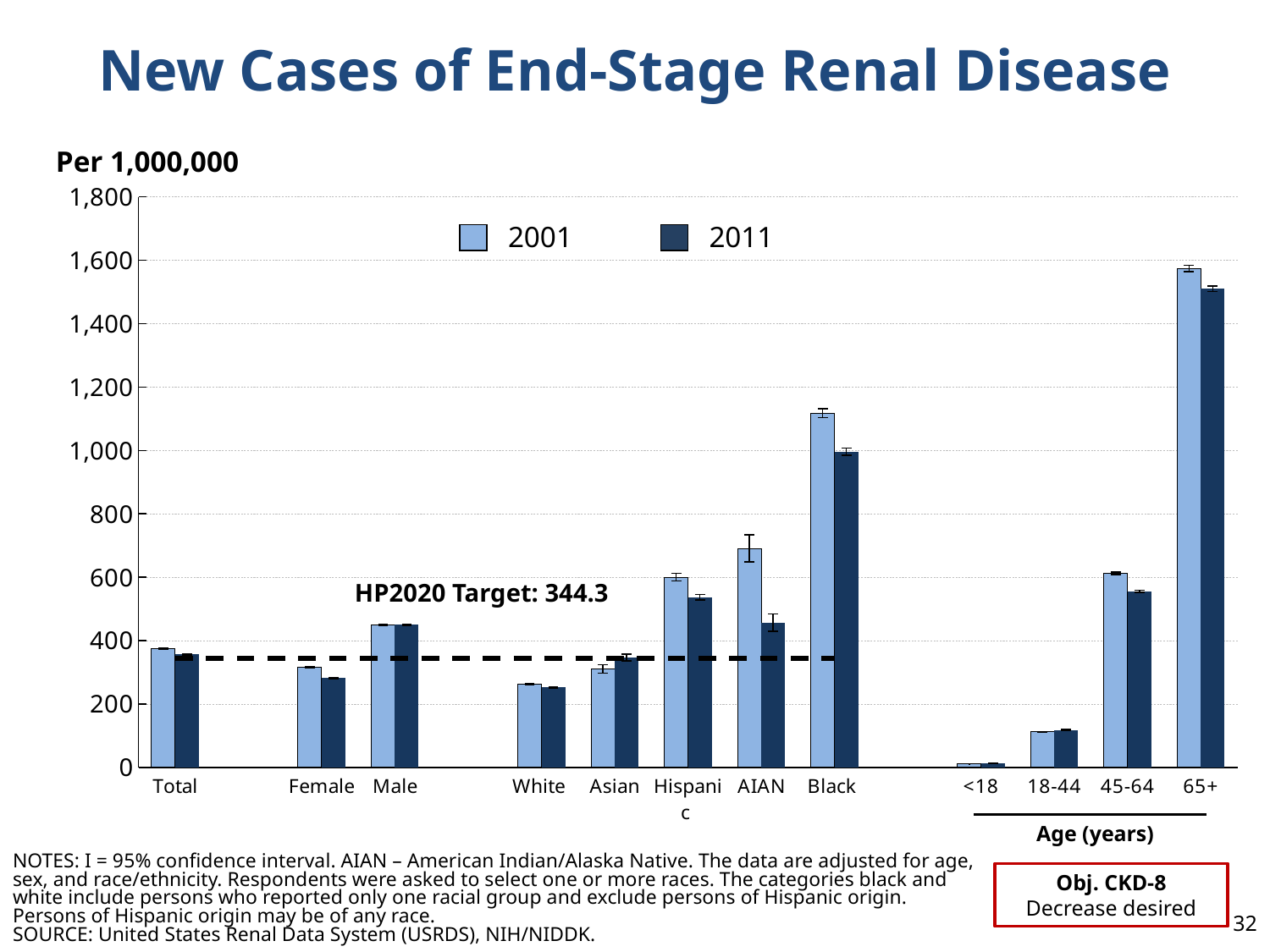
What type of chart is shown on the slide? bar chart For AIAN, which year has the larger value, 2001 or 2011? 2001 Which category has the highest 2001 value? 65+ Is the 2001 value for Black greater or less than 1,000? greater What is the HP2020 Target value shown on the chart? 344.3 Is the 2001 value for Hispanic greater or less than 400? greater How many categories are shown along the x axis? 12 Which category has the lowest 2001 value? <18 Is the 2011 value for AIAN greater or less than 600? less How many series does the legend list? 2 Which has the larger 2001 value, Black or 65+? 65+